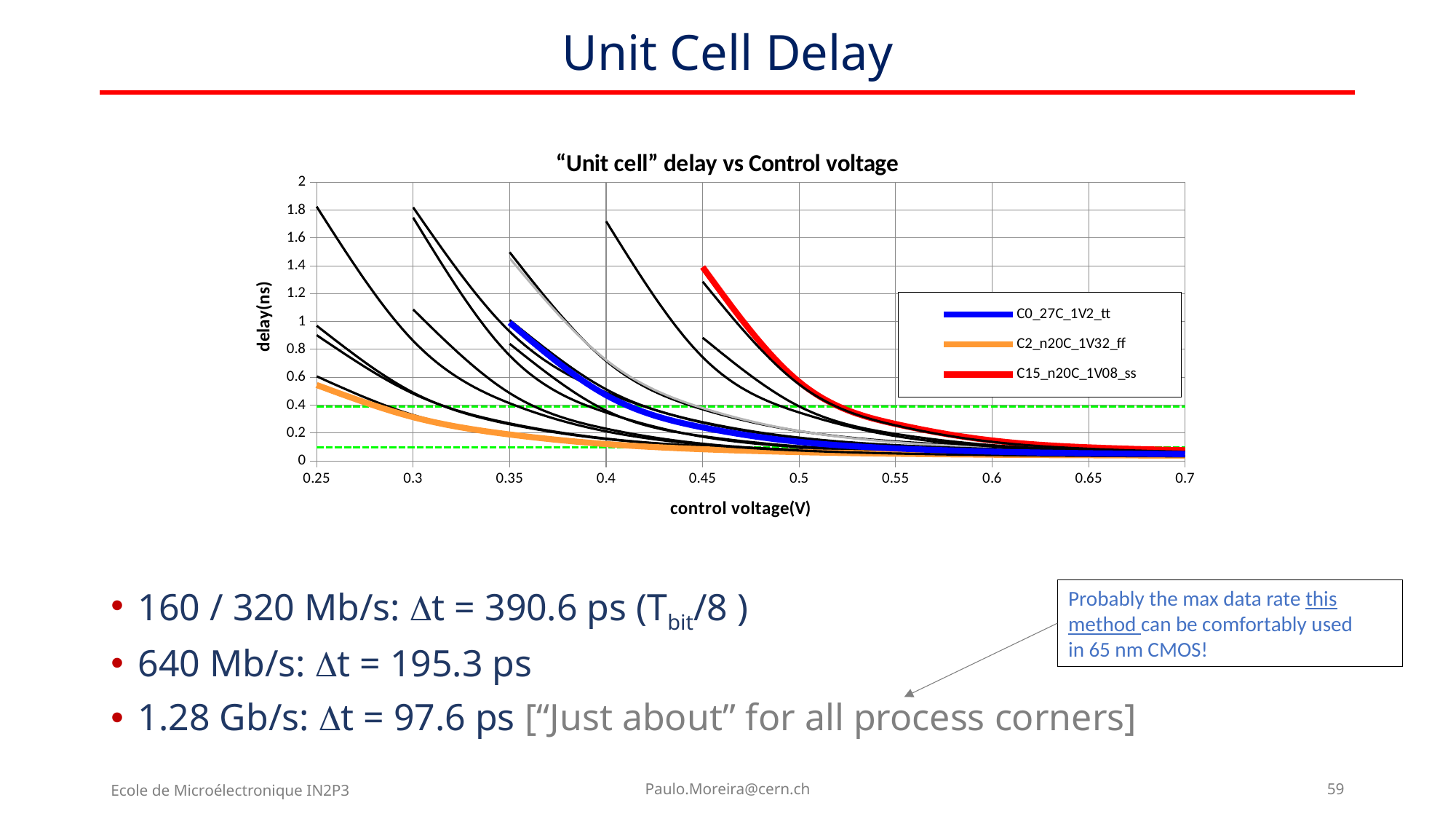
Is the delay for C2_n20C_1V32_ff at a control voltage of 0.25 greater or less than 0.8? less How many series does the chart legend list? 3 Which legend series has the highest delay at a control voltage of 0.45? C15_n20C_1V08_ss Is the delay for C15_n20C_1V08_ss at a control voltage of 0.45 greater or less than 1.2? greater What is the label of the x axis of the chart? control voltage(V) What kind of chart is shown on the slide? line chart At a control voltage of 0.5, which has the larger delay, C15_n20C_1V08_ss or C2_n20C_1V32_ff? C15_n20C_1V08_ss Is the delay for C0_27C_1V2_tt at a control voltage of 0.6 greater or less than 0.4? less What is the title of the chart? "Unit cell" delay vs Control voltage Which legend series has the lowest delay at a control voltage of 0.3? C2_n20C_1V32_ff As control voltage increases along the x axis, does the delay rise or fall? fall